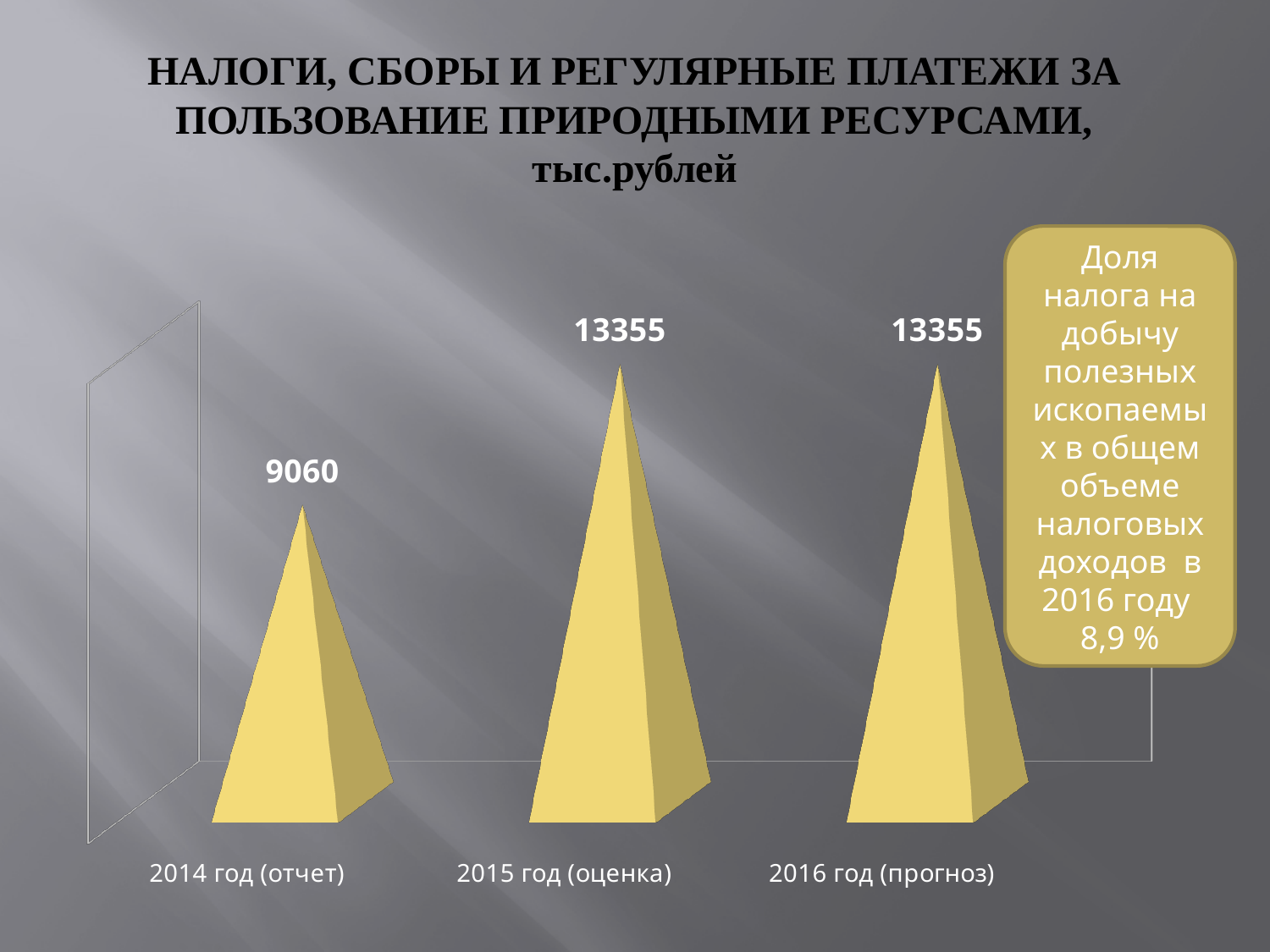
What is the value for 2016 год (прогноз)? 13355 What is the difference between the values for 2016 год (прогноз) and 2015 год (оценка)? 0 Which category has the lowest value? 2014 год (отчет) According to the callout on the slide, what is the share of the mineral extraction tax in total tax revenues in 2016? 8,9 % How many categories are shown on the chart? 3 What is the value for 2014 год (отчет)? 9060 Do the values rise or fall from 2014 год (отчет) to 2015 год (оценка)? rise What is the value for 2015 год (оценка)? 13355 What kind of chart is shown on the slide? bar chart What is the difference between the values for 2015 год (оценка) and 2014 год (отчет)? 4295 Which is larger, the value for 2014 год (отчет) or the value for 2015 год (оценка)? 2015 год (оценка) What unit of measurement is given in the chart title? тыс.рублей